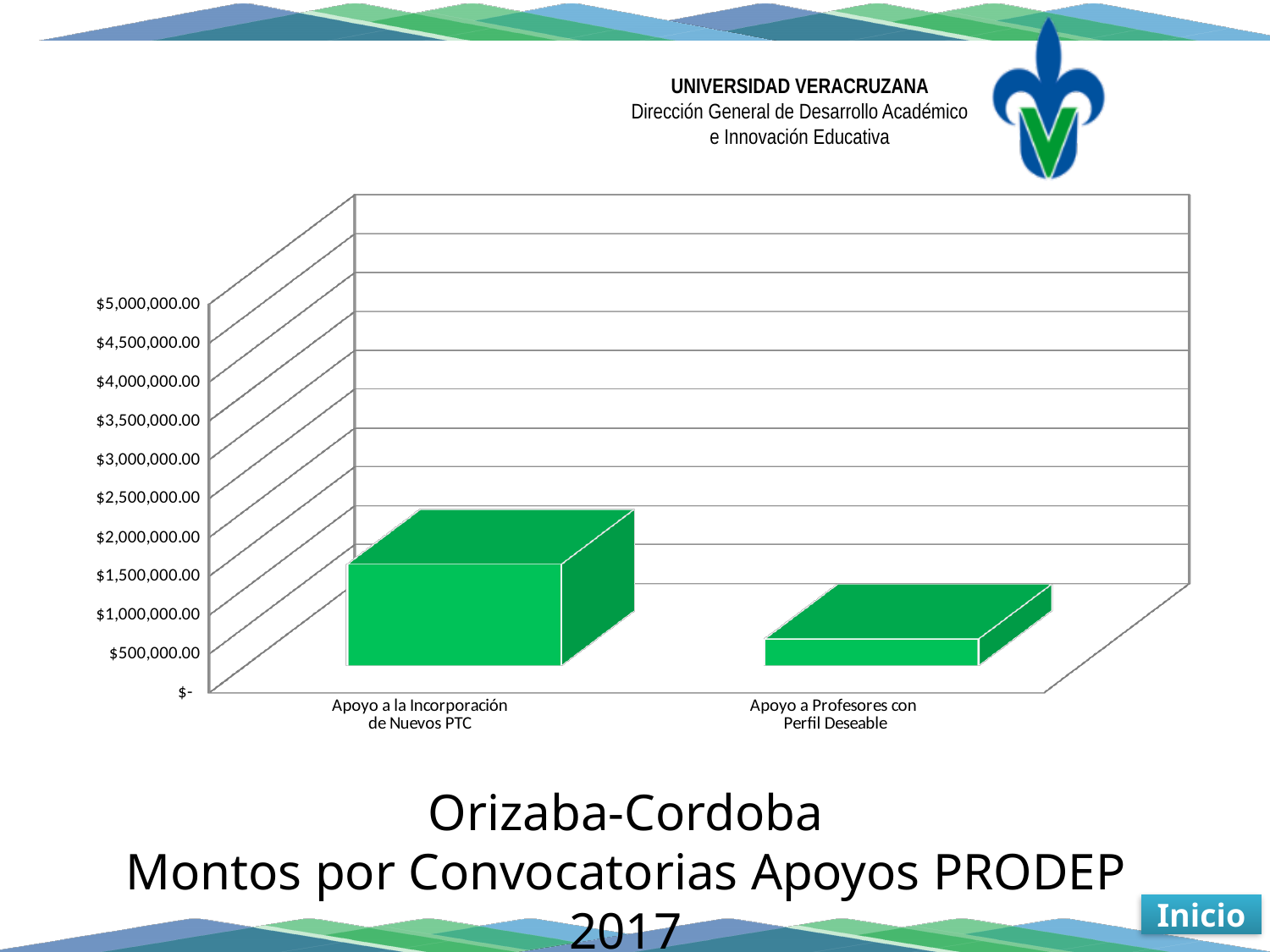
Which is larger: the value for Apoyo a la Incorporación de Nuevos PTC or the value for Apoyo a Profesores con Perfil Deseable? Apoyo a la Incorporación de Nuevos PTC What kind of chart is shown on the slide? bar chart Is the value for Apoyo a Profesores con Perfil Deseable greater or less than $1,000,000.00? less Is the value for Apoyo a Profesores con Perfil Deseable greater or less than $3,000,000.00? less What is the highest value shown on the vertical axis of the chart? $5,000,000.00 Which category has the lowest value in the chart? Apoyo a Profesores con Perfil Deseable How many categories are plotted in the chart? 2 Is the value for Apoyo a la Incorporación de Nuevos PTC greater or less than $2,500,000.00? less What title is shown below the chart? Orizaba-Cordoba Montos por Convocatorias Apoyos PRODEP 2017 Which category has the highest value in the chart? Apoyo a la Incorporación de Nuevos PTC